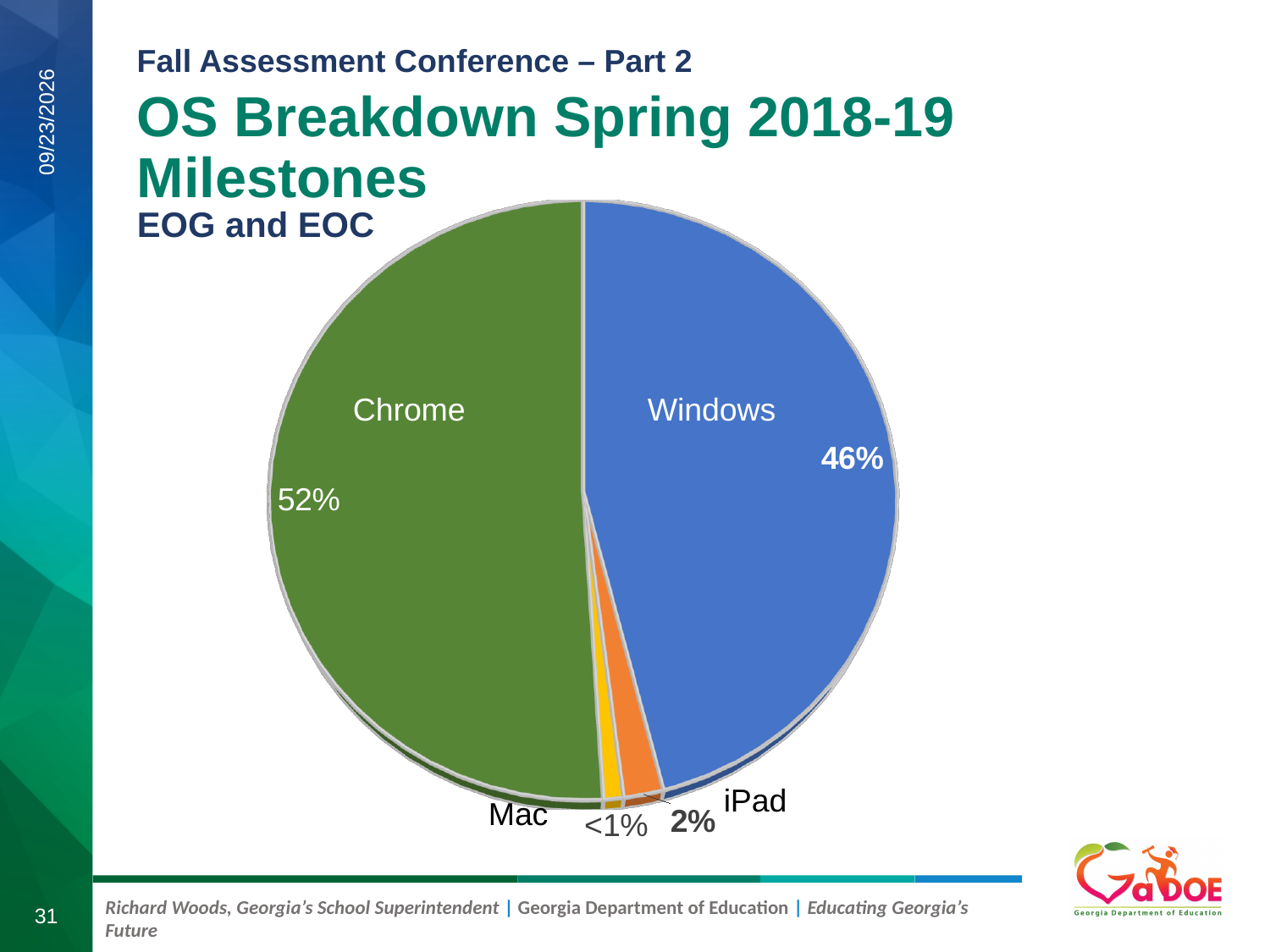
What is the title of the chart on the slide? OS Breakdown Spring 2018-19 Milestones What is the value shown for iPad? 2% What is the value shown for Mac? <1% Which is larger, the Windows slice or the iPad slice? Windows Which operating system has the largest slice of the pie? Chrome How many operating systems are shown in the pie chart? 4 What share of the pie does Windows account for? 46% What is the difference in percentage points between Chrome and Windows? 6 percentage points Which is larger, the Chrome slice or the Windows slice? Chrome What kind of chart is shown on the slide? Pie chart What share of the pie does Chrome account for? 52%